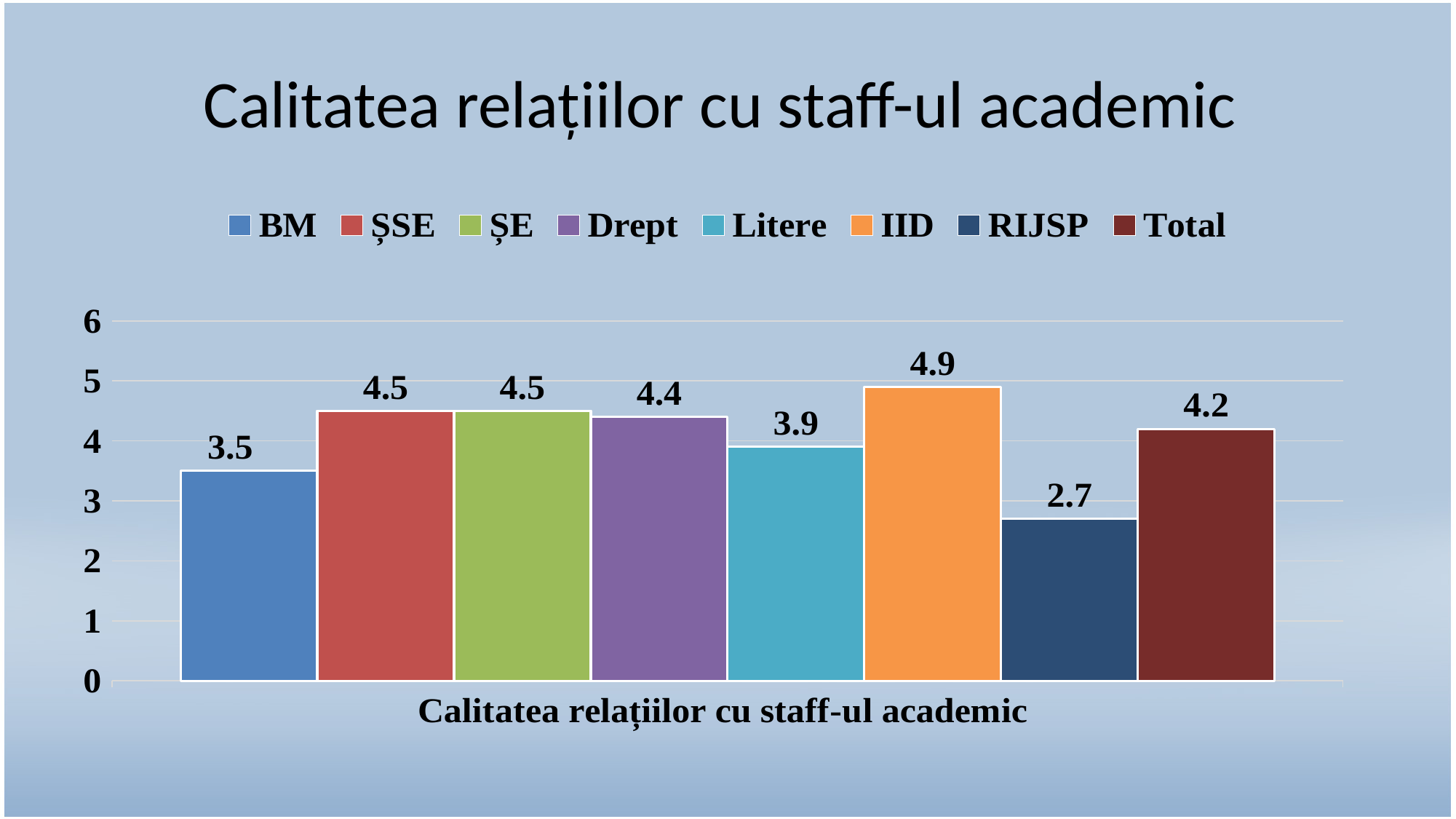
Which series has the lowest value? RIJSP What is the difference between the values for IID and RIJSP? 2.2 Which is larger, the value for Drept or the value for Litere? Drept What is the title of the chart? Calitatea relațiilor cu staff-ul academic What is the value for RIJSP? 2.7 Which series has the highest value? IID What kind of chart is shown on the slide? bar chart What is the value for IID? 4.9 How many series does the legend list? 8 What is the value for BM? 3.5 What is the value for Total? 4.2 Is the value for Litere greater or less than 4? less